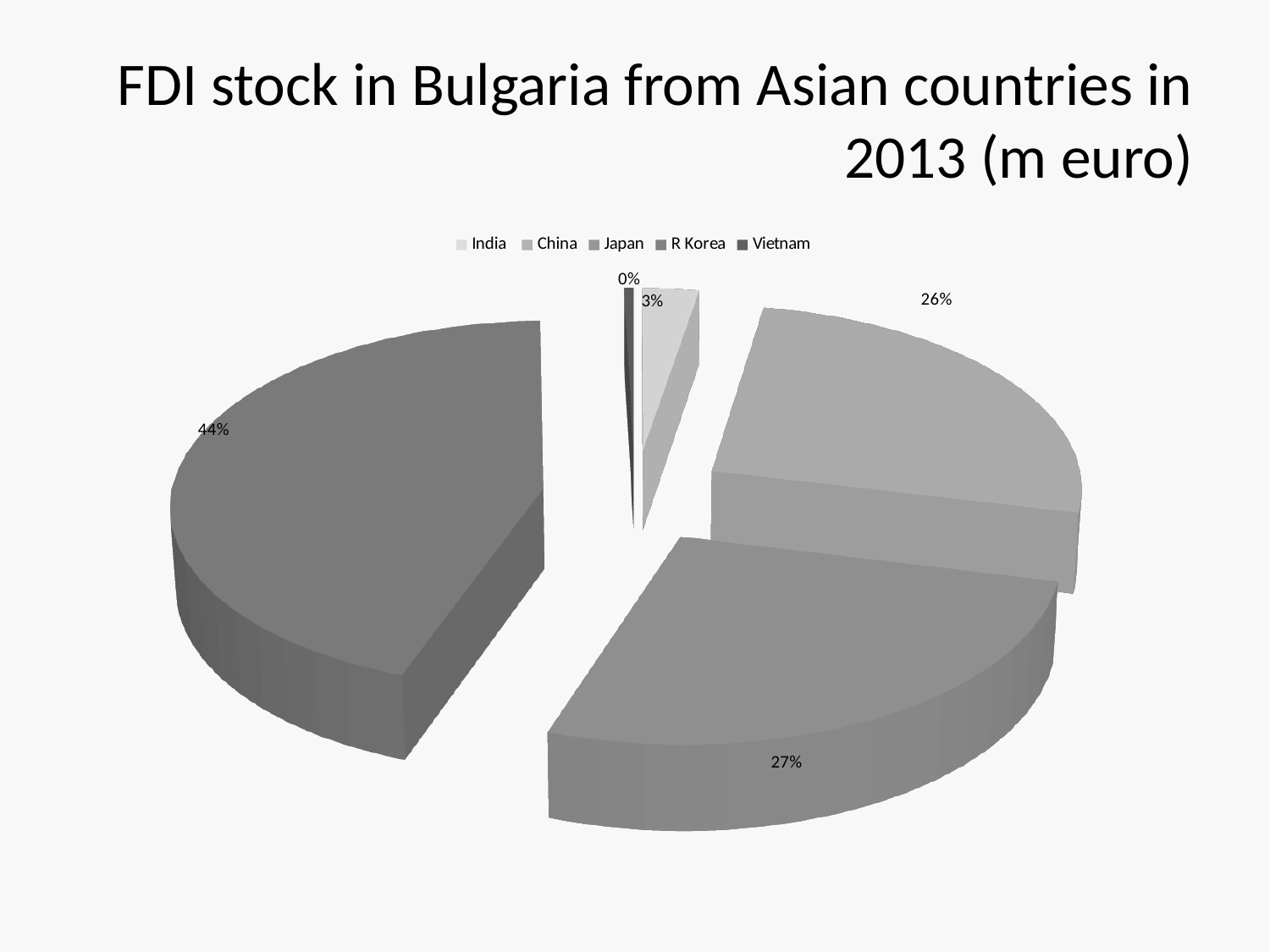
How many countries does the legend list? 5 Which country has the largest share of FDI stock in the chart? R Korea What share of the pie does Vietnam account for? 0% What share of the pie does Japan account for? 27% What is the title of the chart? FDI stock in Bulgaria from Asian countries in 2013 (m euro) What kind of chart is shown on the slide? pie chart What share of the pie does R Korea account for? 44% How many slices does the pie chart have? 5 Which country has the smallest share of FDI stock in the chart? Vietnam What is the difference in percentage points between the shares of R Korea and Japan? 17